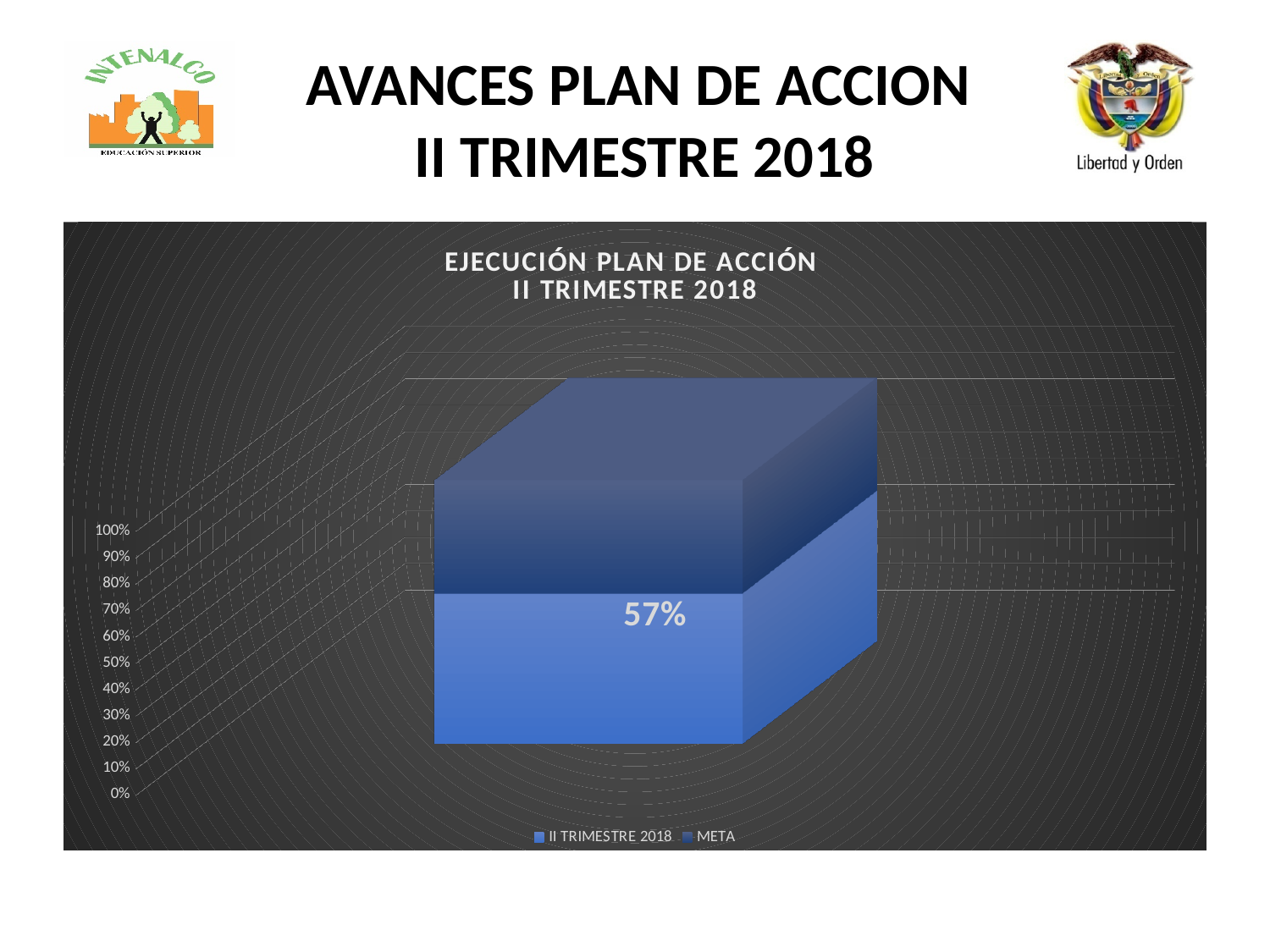
Is the value for II TRIMESTRE 2018 greater or less than 60%? less How many stacked bars are plotted in the chart? 1 What kind of chart is shown on the slide? bar chart Is the value for II TRIMESTRE 2018 greater or less than 50%? greater What is the value shown for the II TRIMESTRE 2018 series in the chart? 57% What is the title of the chart? EJECUCIÓN PLAN DE ACCIÓN II TRIMESTRE 2018 How many series does the chart legend list? 2 What are the two series named in the chart legend? II TRIMESTRE 2018 and META